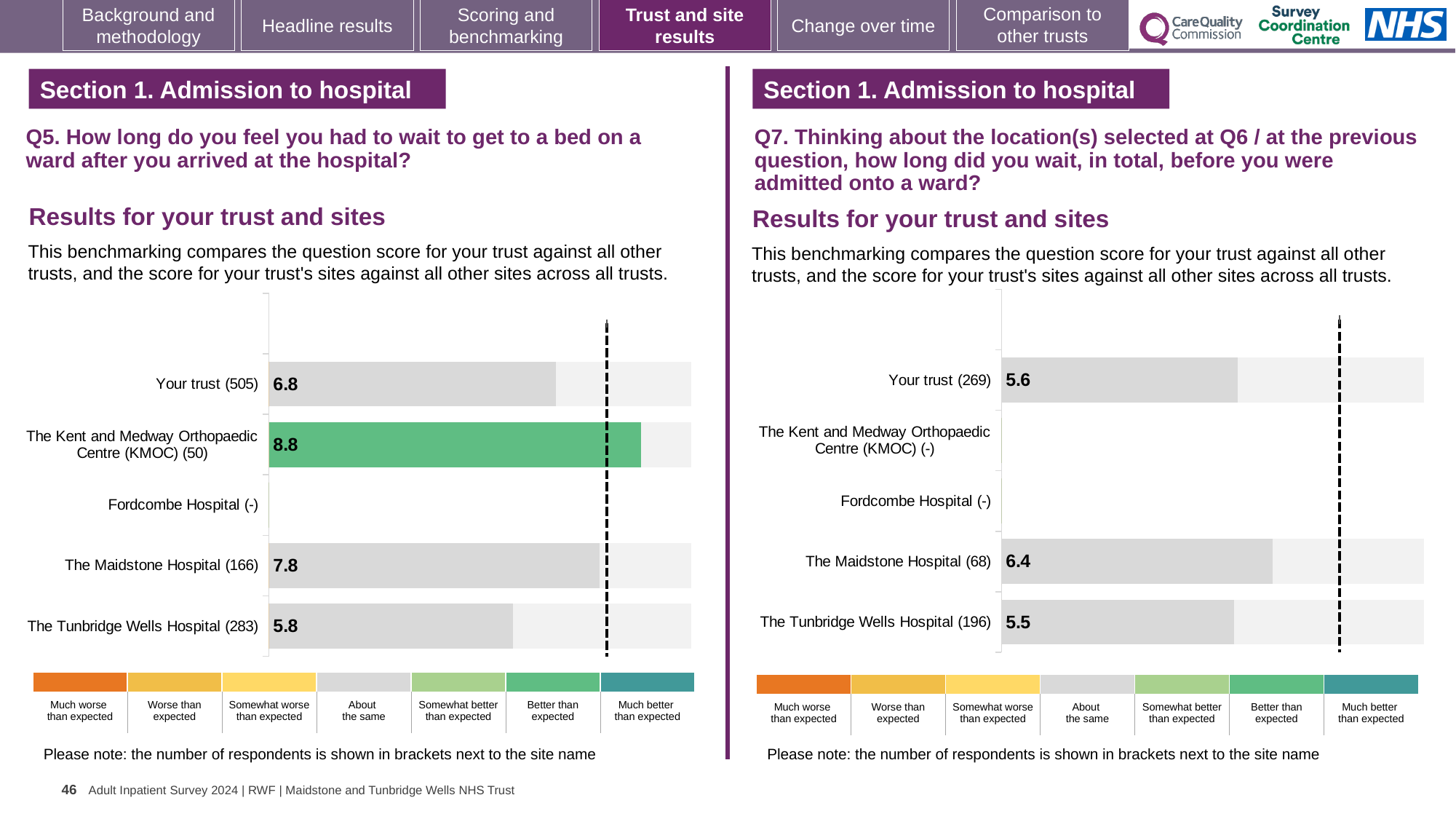
On the Q7 chart (right), how many sites have a score plotted? 3 On the Q7 chart (right), which of Your trust or The Maidstone Hospital has the higher score? The Maidstone Hospital On the Q5 chart (left), what is the score for Your trust? 6.8 On the Q7 chart (right), what is the difference between the scores for The Maidstone Hospital and Your trust? 0.8 On the Q5 chart (left), how many respondents are shown for Your trust? 505 On the Q7 chart (right), what is the score for The Maidstone Hospital? 6.4 On the Q7 chart (right), what is the score for The Tunbridge Wells Hospital? 5.5 What kind of chart is used on the Q5 chart (left)? Bar chart On the Q5 chart (left), what is the score for The Kent and Medway Orthopaedic Centre (KMOC)? 8.8 On the Q5 chart (left), which site has the lowest score? The Tunbridge Wells Hospital On the Q5 chart (left), which site has the highest score? The Kent and Medway Orthopaedic Centre (KMOC) On the Q5 chart (left), what is the difference between the scores for The Maidstone Hospital and The Tunbridge Wells Hospital? 2.0